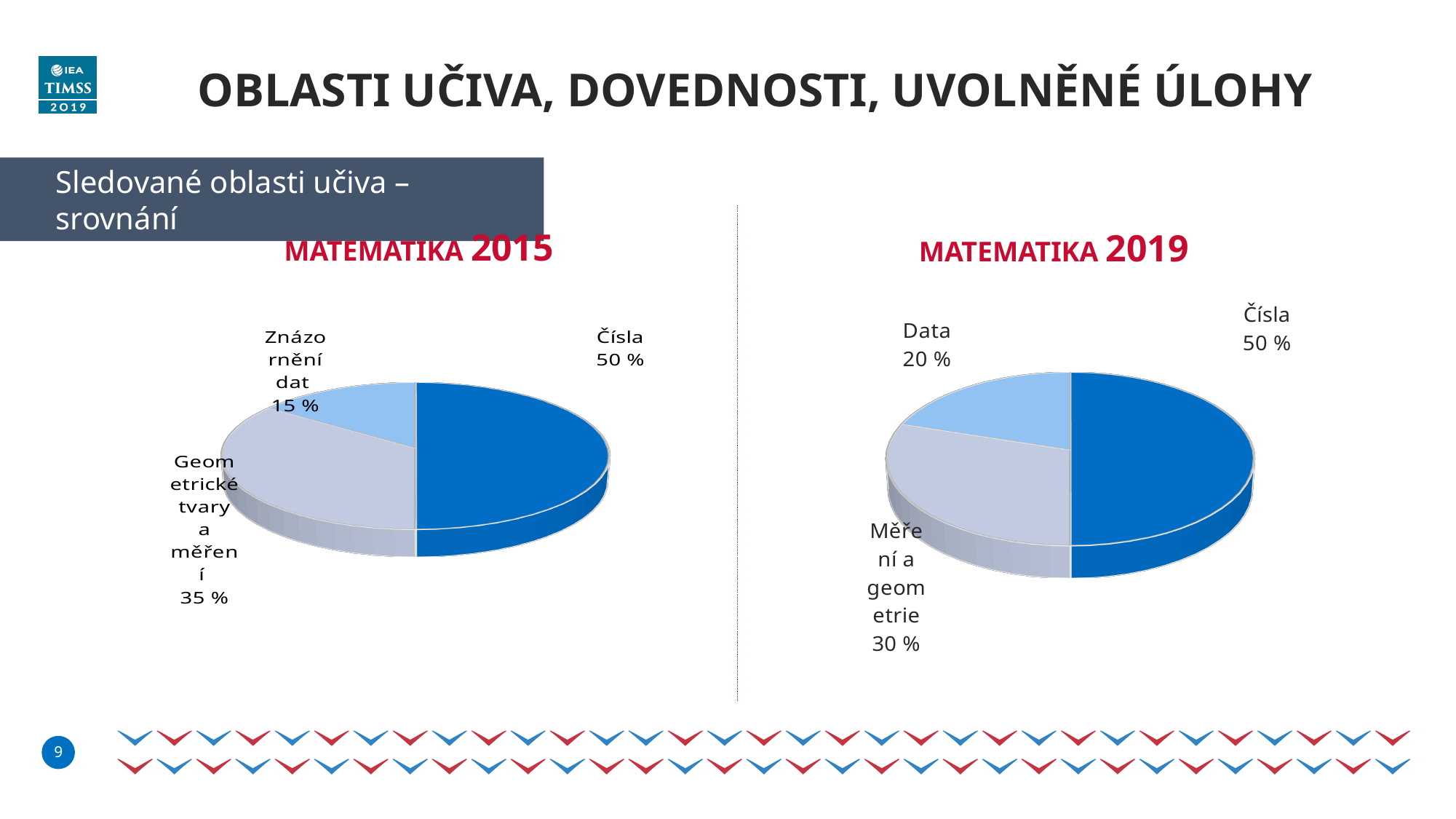
What kind of chart is the MATEMATIKA 2015 chart? Pie chart In the MATEMATIKA 2015 chart, which is larger: Geometrické tvary a měření or Znázornění dat? Geometrické tvary a měření In the MATEMATIKA 2015 chart, what share does Znázornění dat have? 15 % In the MATEMATIKA 2015 chart, what share does Čísla have? 50 % In the MATEMATIKA 2015 chart, which category has the smallest share? Znázornění dat How many slices does the MATEMATIKA 2019 chart have? 3 In the MATEMATIKA 2019 chart, which category has the largest share? Čísla What is the title of the chart on the right side of the slide? MATEMATIKA 2019 In the MATEMATIKA 2015 chart, what share does Geometrické tvary a měření have? 35 % In the MATEMATIKA 2019 chart, what share does Data have? 20 % In the MATEMATIKA 2019 chart, what share does Měření a geometrie have? 30 % In the MATEMATIKA 2019 chart, what is the difference between the shares of Čísla and Data? 30 %